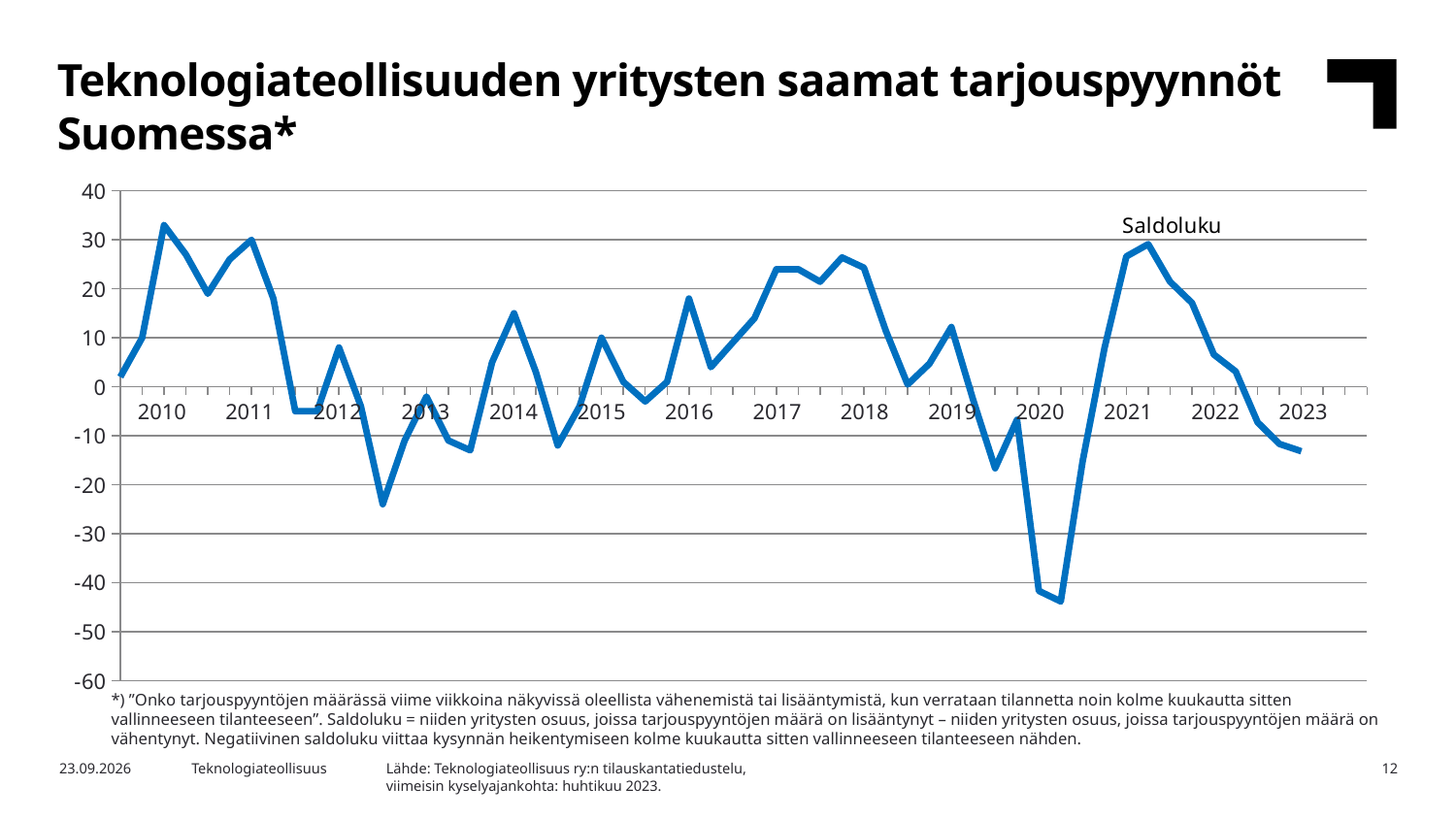
Is the Saldoluku value at the end of 2023 higher or lower than the value at the start of 2010? lower How many years are labelled on the x axis of the chart? 14 What is the title of the chart on the slide? Teknologiateollisuuden yritysten saamat tarjouspyynnöt Suomessa* Is the lowest value of the Saldoluku line in 2012 greater or less than -20? less How many series are plotted in the chart? 1 Is the lowest value of the Saldoluku line in 2020 greater or less than -40? less Is the peak value of the Saldoluku line in 2010 greater or less than 30? greater What is the name of the series plotted in the chart? Saldoluku Does the Saldoluku line rise or fall from its 2021 peak to the end of 2023? fall What kind of chart is shown on the slide? line chart In which year does the Saldoluku line reach its lowest value? 2020